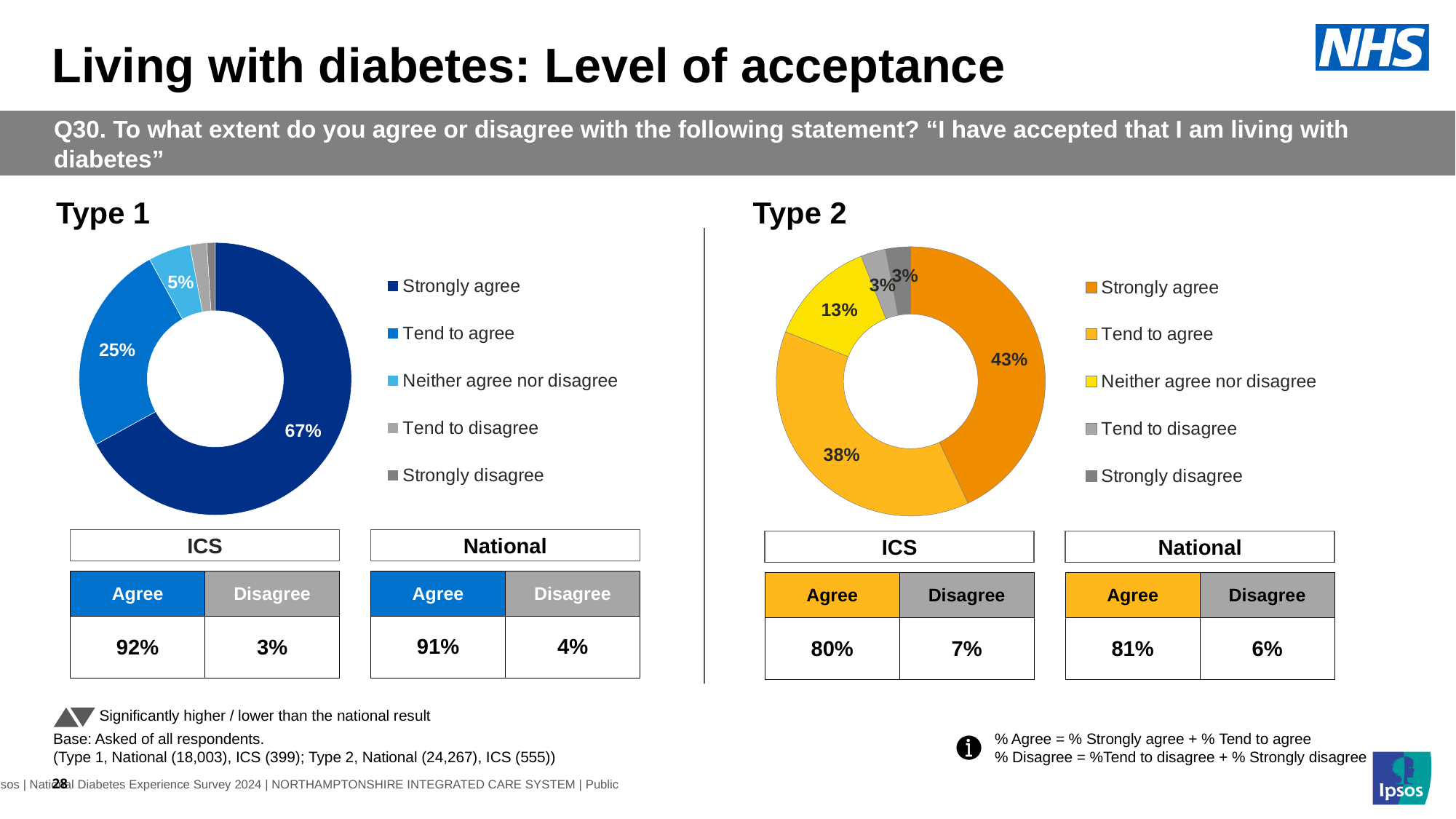
In the Type 2 chart, what percentage of respondents said 'Neither agree nor disagree'? 13% In the Type 1 chart, what percentage of respondents said 'Neither agree nor disagree'? 5% In the Type 2 chart, what percentage of respondents said 'Strongly agree'? 43% In the Type 2 chart, what is the difference between the 'Strongly agree' and 'Tend to agree' percentages? 5% Which chart has the larger 'Neither agree nor disagree' share, Type 1 or Type 2? Type 2 In the Type 1 chart, what percentage of respondents said 'Strongly agree'? 67% How many categories does the legend of the Type 2 chart list? 5 In the Type 1 chart, what is the difference between the 'Strongly agree' and 'Tend to agree' percentages? 42% In the Type 1 chart, what percentage of respondents said 'Tend to agree'? 25% In the Type 2 chart, which category has the largest share? Strongly agree In the Type 2 chart, what percentage of respondents said 'Tend to agree'? 38% In the Type 1 chart, which category has the largest share? Strongly agree